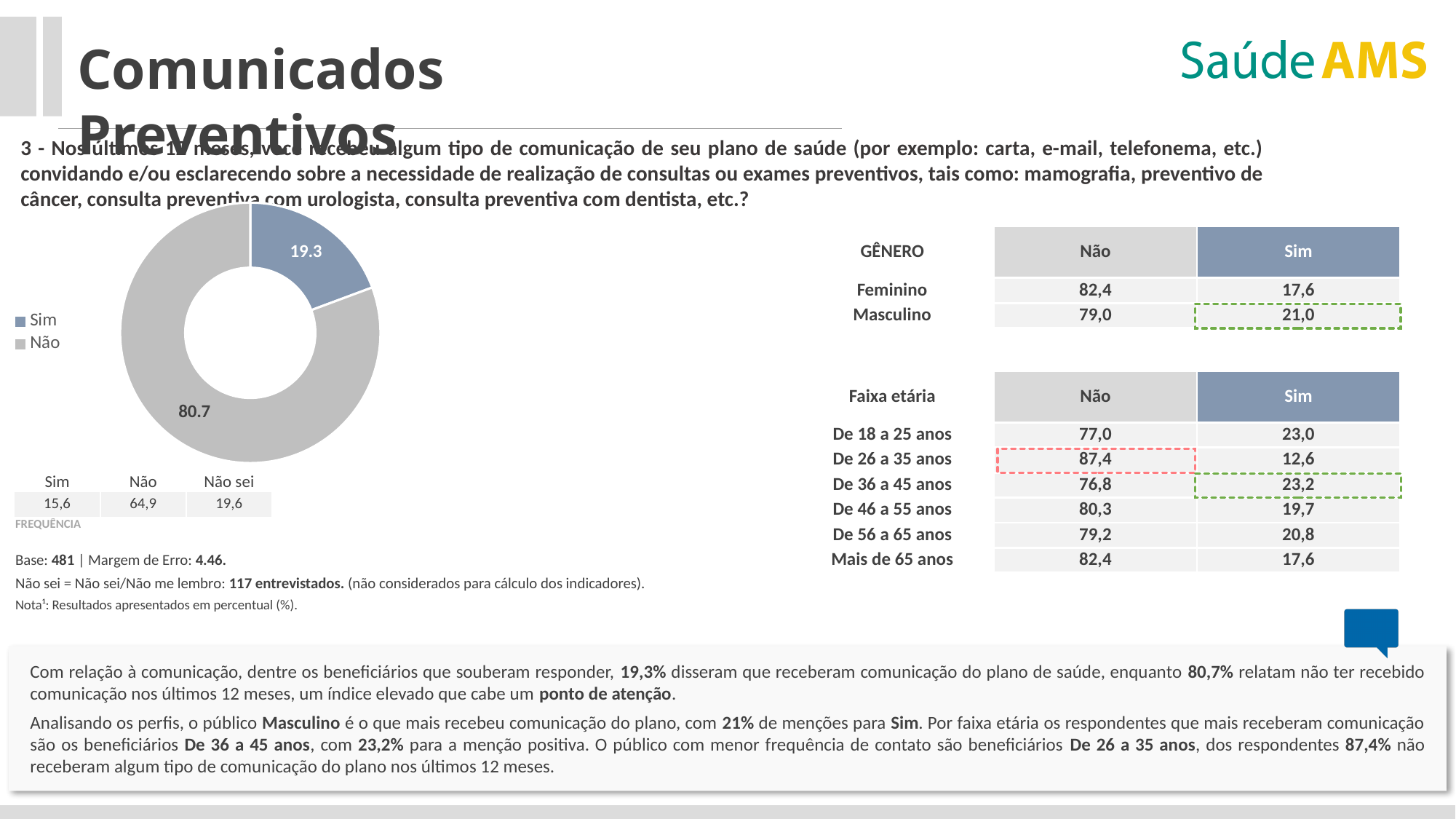
Which category has the smallest slice in the donut chart? Sim In the donut chart, which is larger, the value for Sim or the value for Não? Não What value is shown for the Não slice in the donut chart? 80.7 What are the two legend entries of the donut chart? Sim and Não What kind of chart is shown on the left of the slide? Pie (donut) chart What share of the donut chart does the Não slice represent? 80.7 What is the difference between the Não and Sim values in the donut chart? 61.4 What colour is the Sim slice in the donut chart? Blue How many entries does the legend of the donut chart list? 2 How many slices does the donut chart have? 2 Which category has the largest slice in the donut chart? Não What value is shown for the Sim slice in the donut chart? 19.3